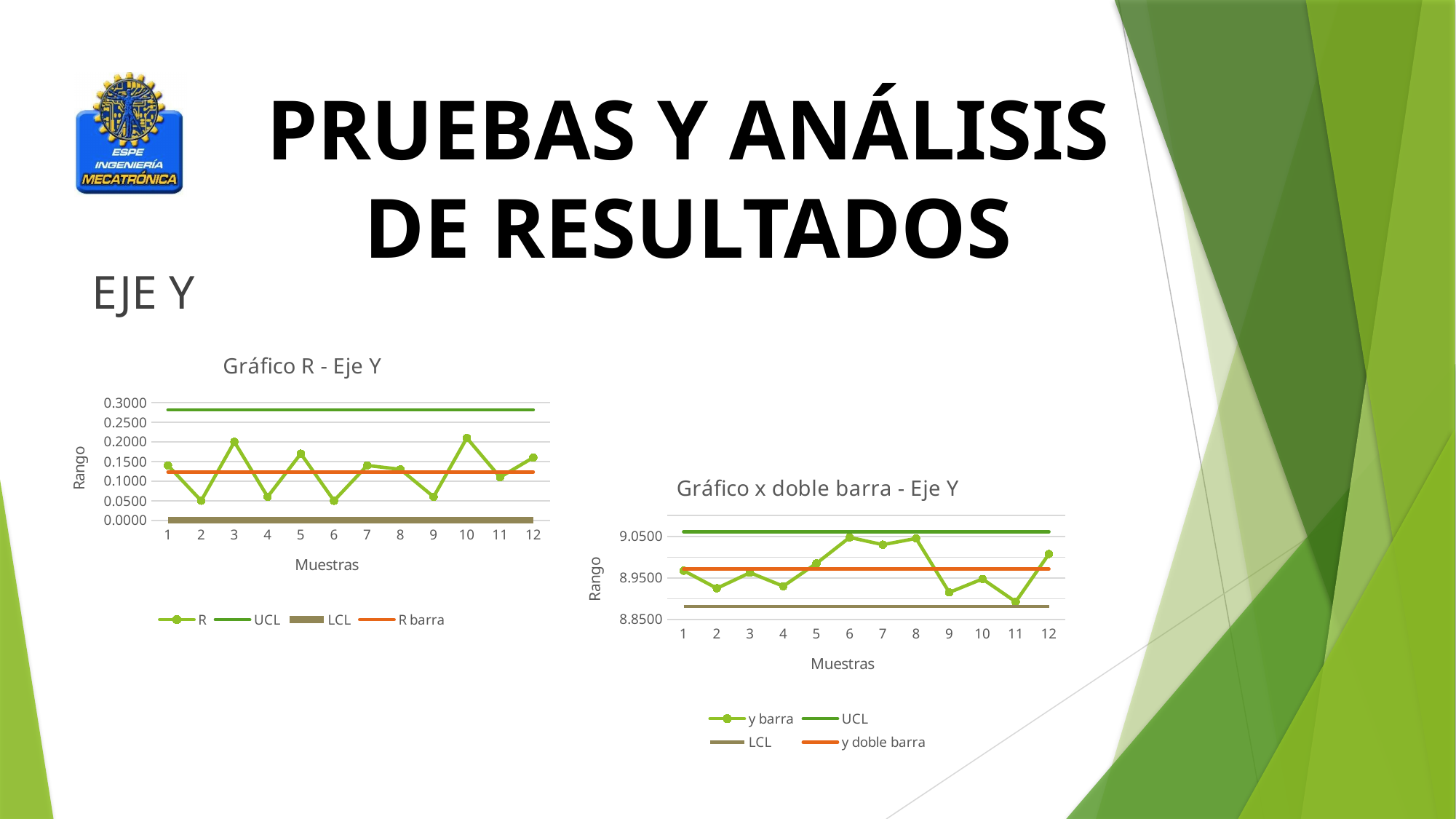
What kind of chart is "Gráfico R - Eje Y"? line chart In "Gráfico x doble barra - Eje Y", what is the name of the series drawn in orange? y doble barra How many series does the legend of "Gráfico R - Eje Y" list? 4 How many samples (Muestras) are plotted on the x axis of "Gráfico R - Eje Y"? 12 In "Gráfico R - Eje Y", is the R value for sample 3 greater or less than 0.1500? greater In "Gráfico R - Eje Y", which has the larger R value, sample 3 or sample 2? sample 3 In "Gráfico x doble barra - Eje Y", which sample has the lowest y barra value? 11 In "Gráfico R - Eje Y", is the R value for sample 2 greater or less than 0.1000? less In "Gráfico x doble barra - Eje Y", which has the larger y barra value, sample 6 or sample 11? sample 6 How many series does the legend of "Gráfico x doble barra - Eje Y" list? 4 In "Gráfico R - Eje Y", what is the label of the y axis? Rango In "Gráfico x doble barra - Eje Y", is the y barra value for sample 6 greater or less than 8.9500? greater